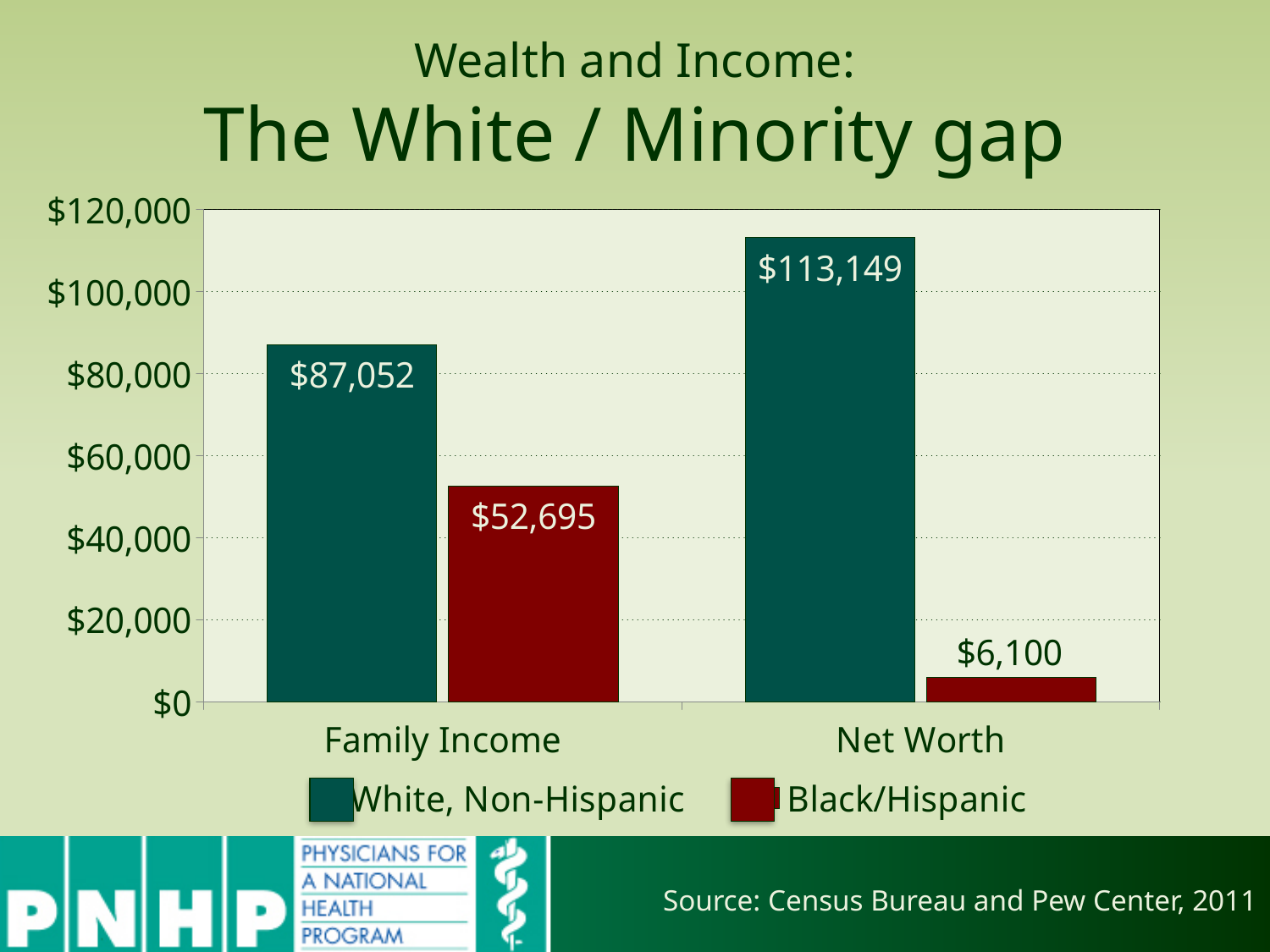
What is the difference between the White, Non-Hispanic and Black/Hispanic Net Worth values? $107,049 What is the difference between the White, Non-Hispanic and Black/Hispanic Family Income values? $34,357 What is the Net Worth value for Black/Hispanic? $6,100 How many categories are shown on the x axis? 2 What is the Net Worth value for White, Non-Hispanic? $113,149 What is the Family Income value for White, Non-Hispanic? $87,052 Which bar has the lowest value on the chart? Black/Hispanic Net Worth Which bar has the highest value on the chart? White, Non-Hispanic Net Worth Which is larger: White, Non-Hispanic Family Income or White, Non-Hispanic Net Worth? White, Non-Hispanic Net Worth How many series does the legend list? 2 What is the Family Income value for Black/Hispanic? $52,695 What kind of chart is shown on the slide? Bar chart